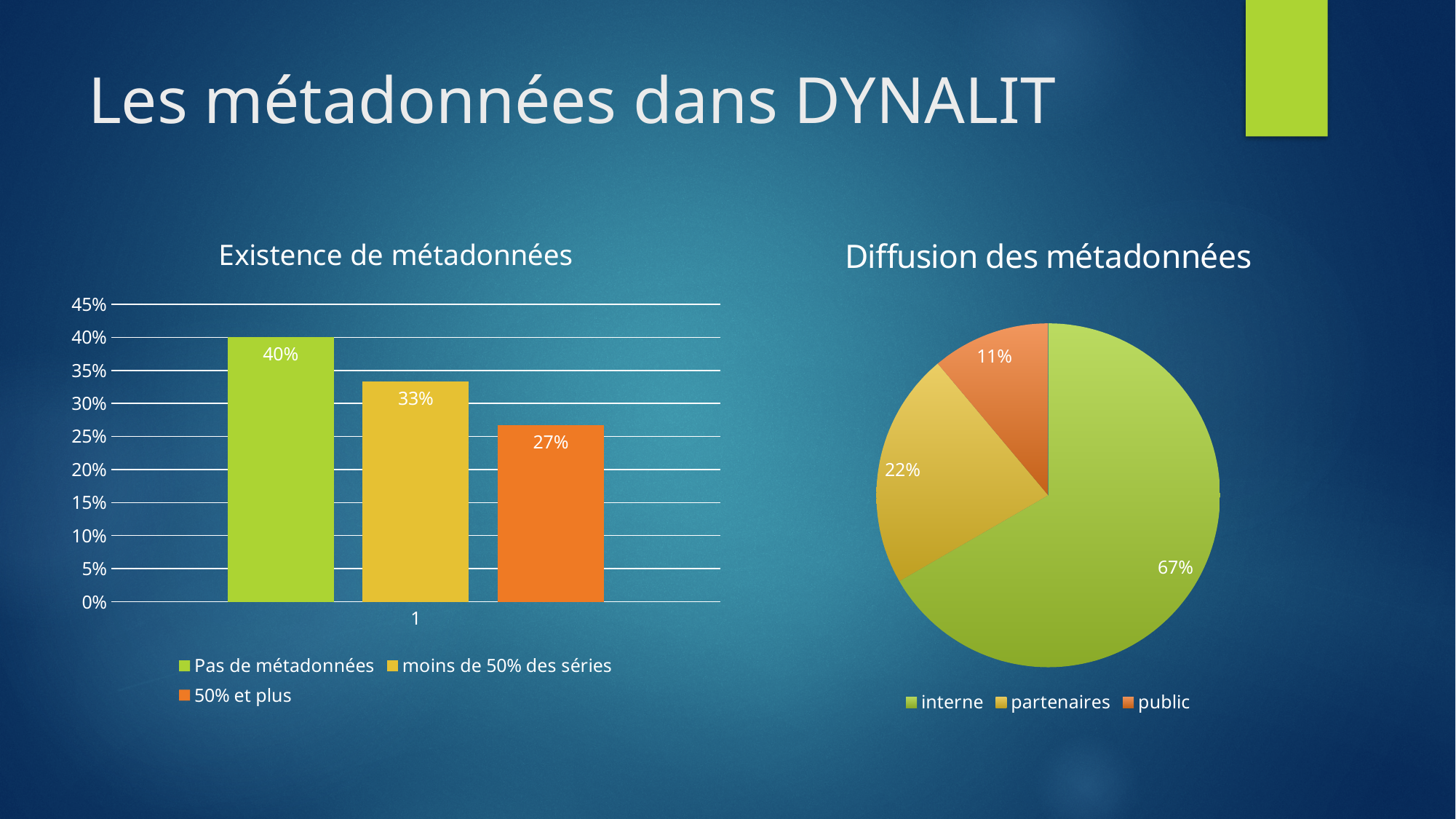
In the 'Existence de métadonnées' chart, which series has the lowest value? 50% et plus What kind of chart is 'Diffusion des métadonnées'? pie chart In the 'Existence de métadonnées' chart, how many series does the legend list? 3 In the 'Existence de métadonnées' chart, what is the value for '50% et plus'? 27% In the 'Existence de métadonnées' chart, what is the difference between 'Pas de métadonnées' and 'moins de 50% des séries'? 7% In the 'Existence de métadonnées' chart, what is the value for 'Pas de métadonnées'? 40% In the 'Diffusion des métadonnées' chart, what share does 'public' have? 11% In the 'Diffusion des métadonnées' chart, what share does 'partenaires' have? 22% In the 'Diffusion des métadonnées' chart, which slice is the largest? interne What kind of chart is 'Existence de métadonnées'? bar chart In the 'Existence de métadonnées' chart, which series has the highest value? Pas de métadonnées In the 'Diffusion des métadonnées' chart, which is larger, 'partenaires' or 'public'? partenaires